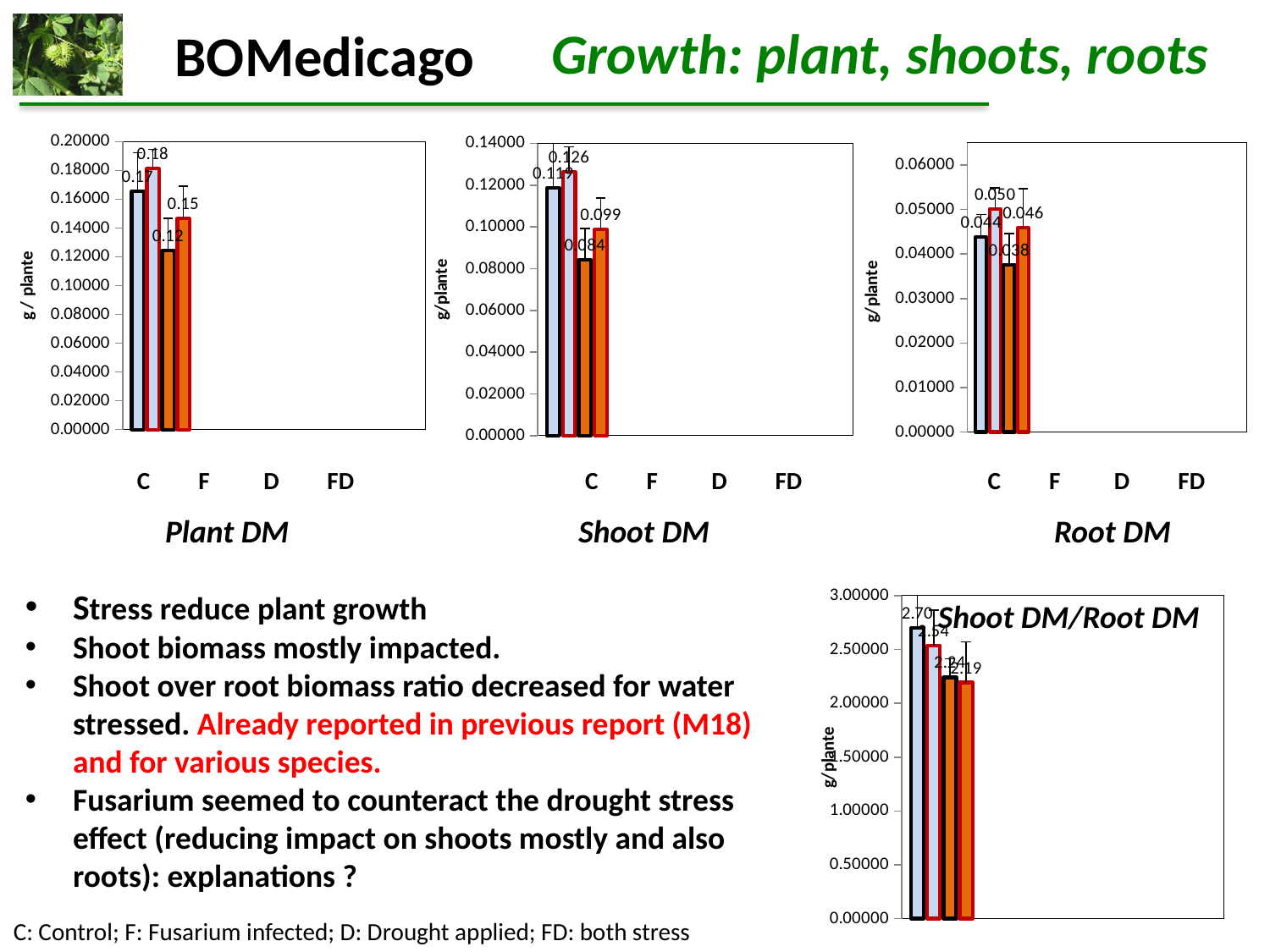
In the Root DM chart, what is the value for D? 0.038 In the Root DM chart, which is larger, the value for F or the value for FD? F In the Shoot DM/Root DM chart, what is the value for C? 2.70 In the Root DM chart, is the value for C greater or less than 0.04000? greater In the Shoot DM chart, what is the difference between the values for C and D? 0.035 In the Shoot DM chart, which treatment has the highest value? F In the Shoot DM chart, what is the value for F? 0.126 In the Plant DM chart, which treatment has the lowest value? D In the Shoot DM/Root DM chart, is the value for FD greater or less than 2.50000? less In the Plant DM chart, what is the value for C? 0.17 What kind of chart is the Root DM chart? bar chart How many treatment categories are shown in the Plant DM chart? 4